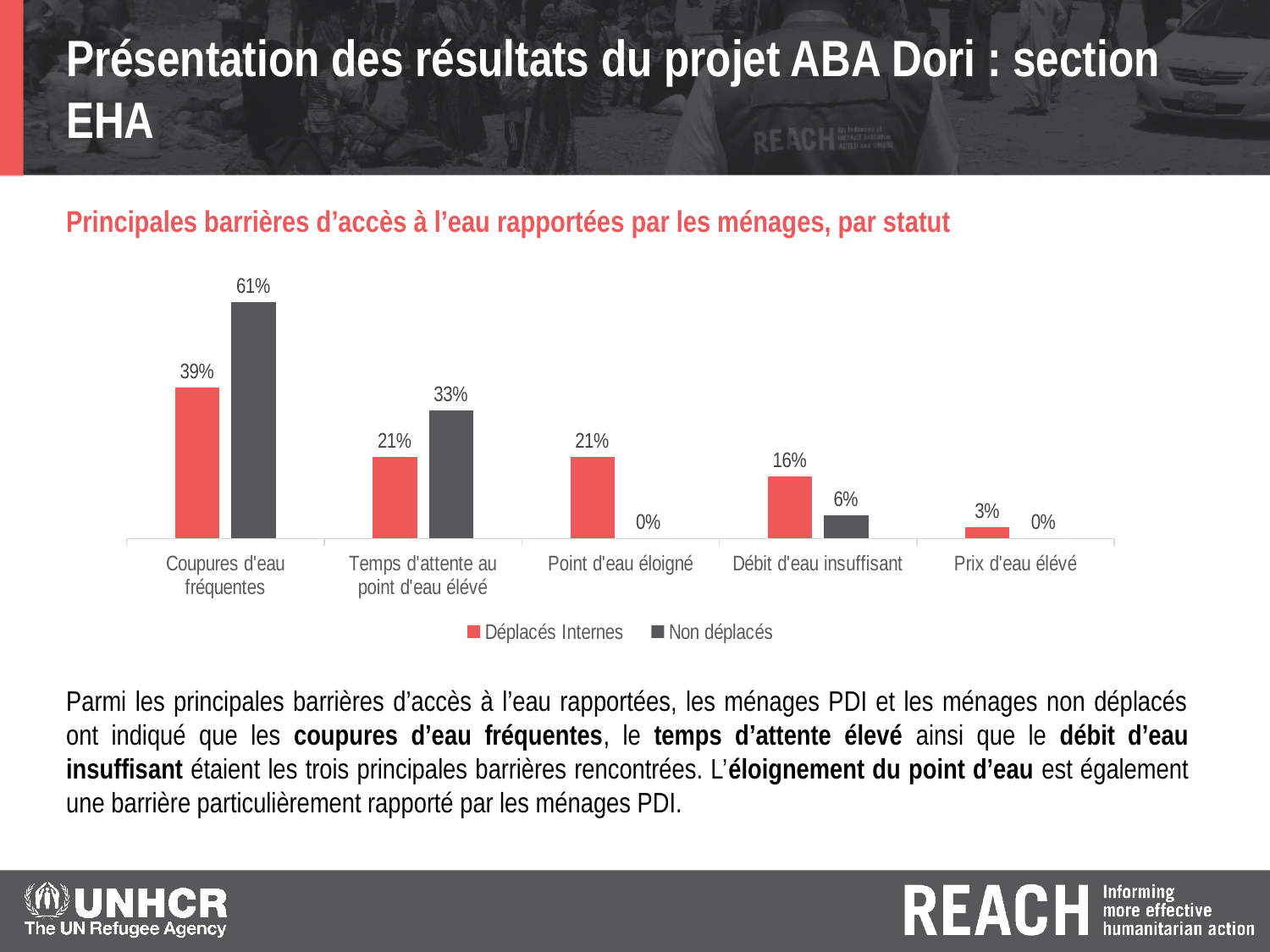
Which category has the lowest value for Déplacés Internes? Prix d'eau élévé How many categories are shown on the x axis? 5 What is the difference between the Non déplacés and Déplacés Internes values for Temps d'attente au point d'eau élévé? 12% What is the difference between the Non déplacés and Déplacés Internes values for Coupures d'eau fréquentes? 22% Which category has the highest value for Déplacés Internes? Coupures d'eau fréquentes For Débit d'eau insuffisant, which series has the larger value, Déplacés Internes or Non déplacés? Déplacés Internes What is the value for Non déplacés in the Coupures d'eau fréquentes category? 61% What is the value for Non déplacés in the Débit d'eau insuffisant category? 6% What colour represents the Déplacés Internes series? Red How many series does the legend list? 2 What kind of chart is shown on the slide? Bar chart What is the value for Déplacés Internes in the Point d'eau éloigné category? 21%